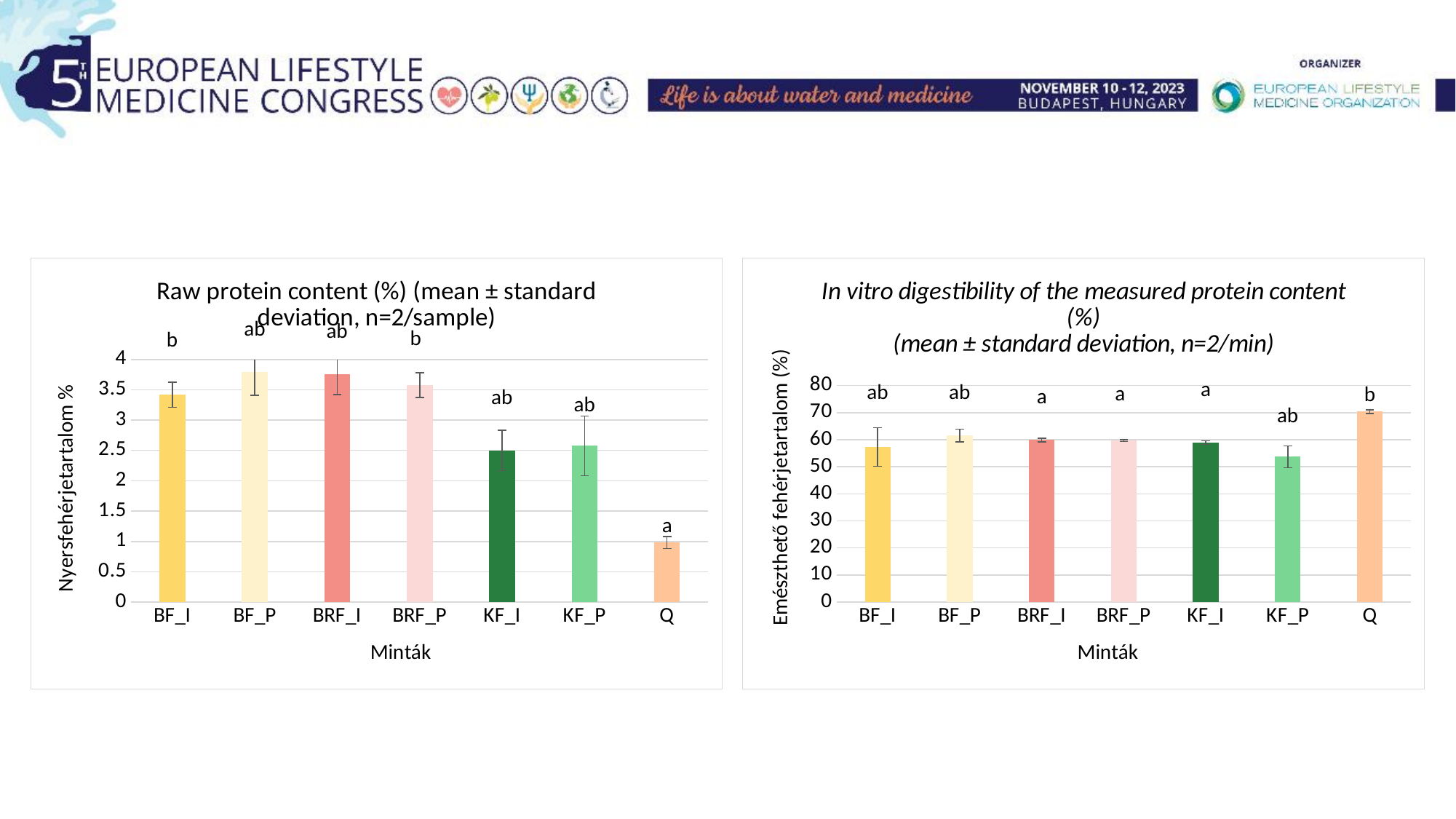
In the 'In vitro digestibility of the measured protein content (%)' chart, is the value for KF_P greater or less than 60? less In the 'Raw protein content (%)' chart, which sample has the lowest raw protein content? Q In the 'Raw protein content (%)' chart, is the value for KF_I greater or less than 2? greater In the 'In vitro digestibility of the measured protein content (%)' chart, which sample has the highest digestibility? Q In the 'In vitro digestibility of the measured protein content (%)' chart, which is larger, the value for Q or the value for KF_P? Q In the 'Raw protein content (%)' chart, is the value for Q greater or less than 1.5? less How many sample categories are shown on the x axis of the 'Raw protein content (%)' chart? 7 What kind of chart is the 'Raw protein content (%)' chart on the left? bar chart In the 'Raw protein content (%)' chart, which is larger, the value for BF_I or the value for KF_I? BF_I What is the x-axis title of the 'In vitro digestibility of the measured protein content (%)' chart? Minták